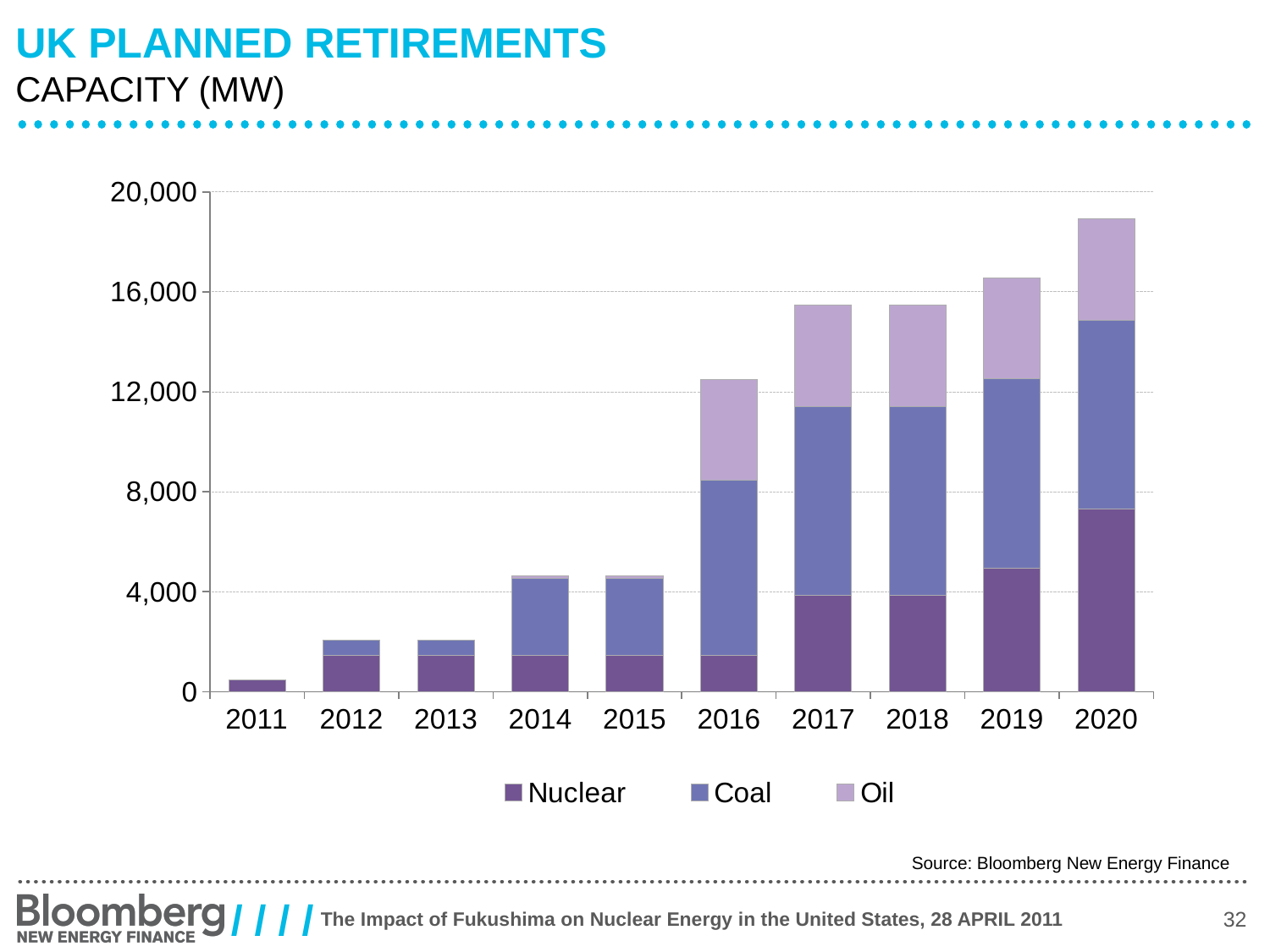
Do the total planned retirements generally rise or fall from 2011 to 2020? rise Which year has the highest total planned retirement capacity? 2020 How many series does the legend list? 3 Which series are listed in the legend? Nuclear, Coal, Oil Is the total value for 2011 greater or less than 4,000? less Is the total value for 2020 greater or less than 16,000? greater Is the total value for 2016 greater or less than 8,000? greater What kind of chart is shown on the slide? Stacked bar chart Which year has the larger total planned retirement capacity, 2015 or 2016? 2016 How many years are shown on the x axis? 10 Which year has the lowest total planned retirement capacity? 2011